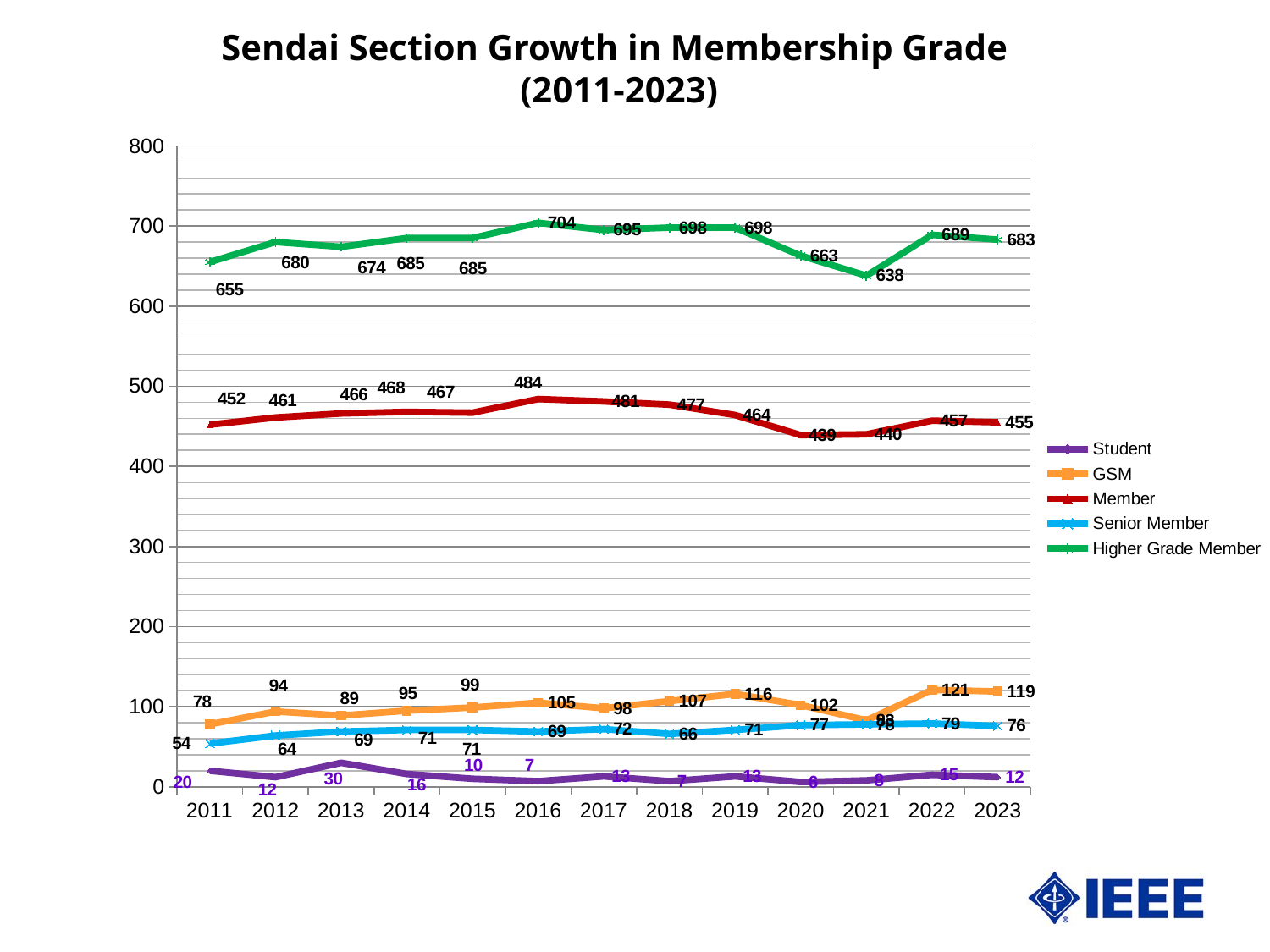
What is the GSM value for 2019? 116 How many years are plotted along the x axis? 13 In which year is the GSM value highest? 2022 What is the difference between the Higher Grade Member values for 2023 and 2011? 28 In which year is the Higher Grade Member value lowest? 2021 Which is larger, the Member value for 2016 or for 2011? 2016 What is the Student value for 2013? 30 Is the Higher Grade Member value for 2021 greater or less than 600? greater What is the Higher Grade Member value for 2016? 704 How many series does the legend list? 5 Does the Higher Grade Member line rise or fall from 2019 to 2021? fall What kind of chart is shown on the slide? line chart